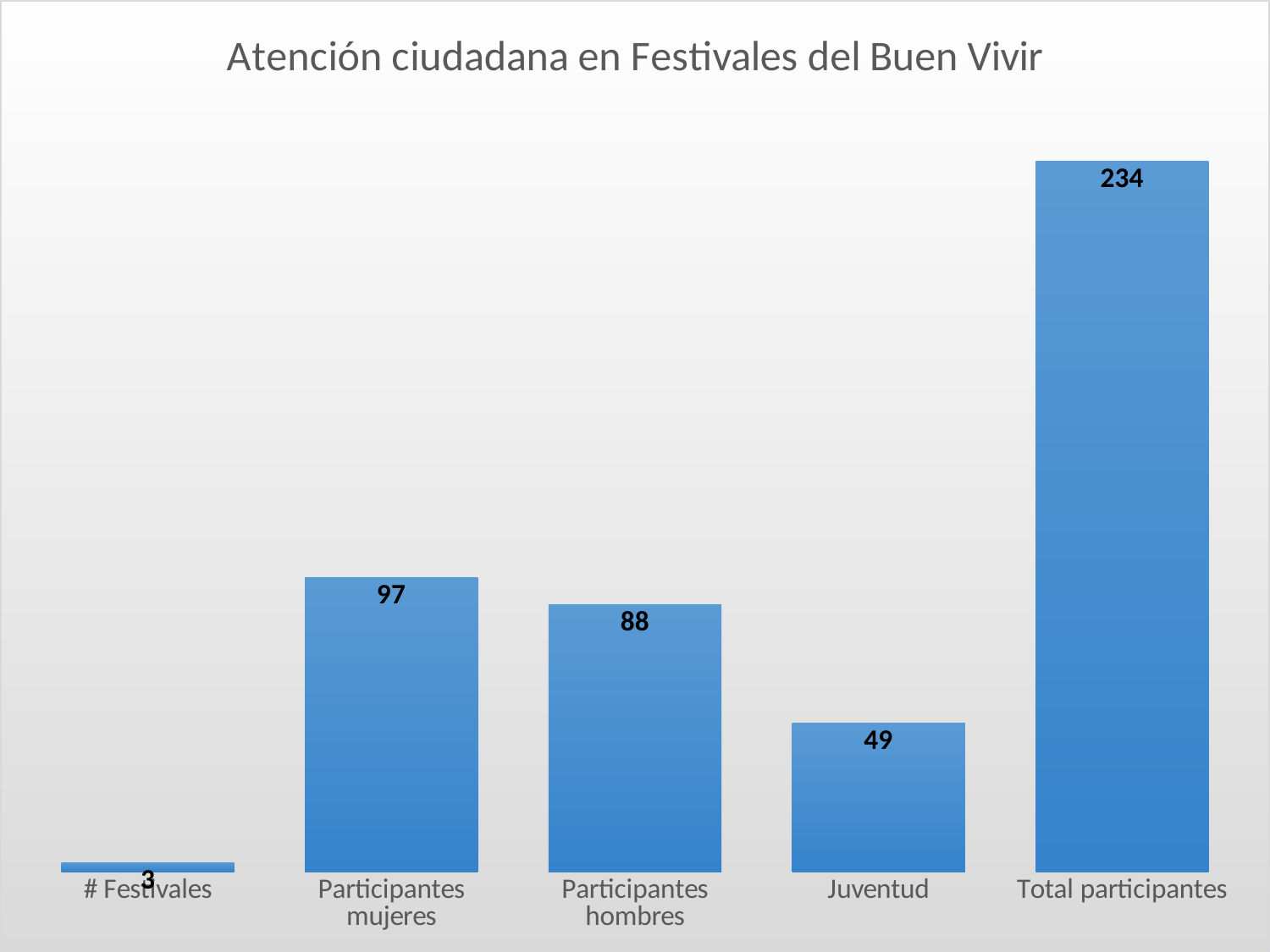
What is the value for # Festivales? 3 Which is larger, Participantes hombres or Juventud? Participantes hombres How many categories are shown on the chart? 5 What kind of chart is this? Bar chart What is the value for Total participantes? 234 What is the value for Participantes mujeres? 97 What is the title of the chart? Atención ciudadana en Festivales del Buen Vivir Which category has the lowest value? # Festivales What is the value for Participantes hombres? 88 Which category has the highest value? Total participantes What is the value for Juventud? 49 What is the difference between Participantes mujeres and Participantes hombres? 9